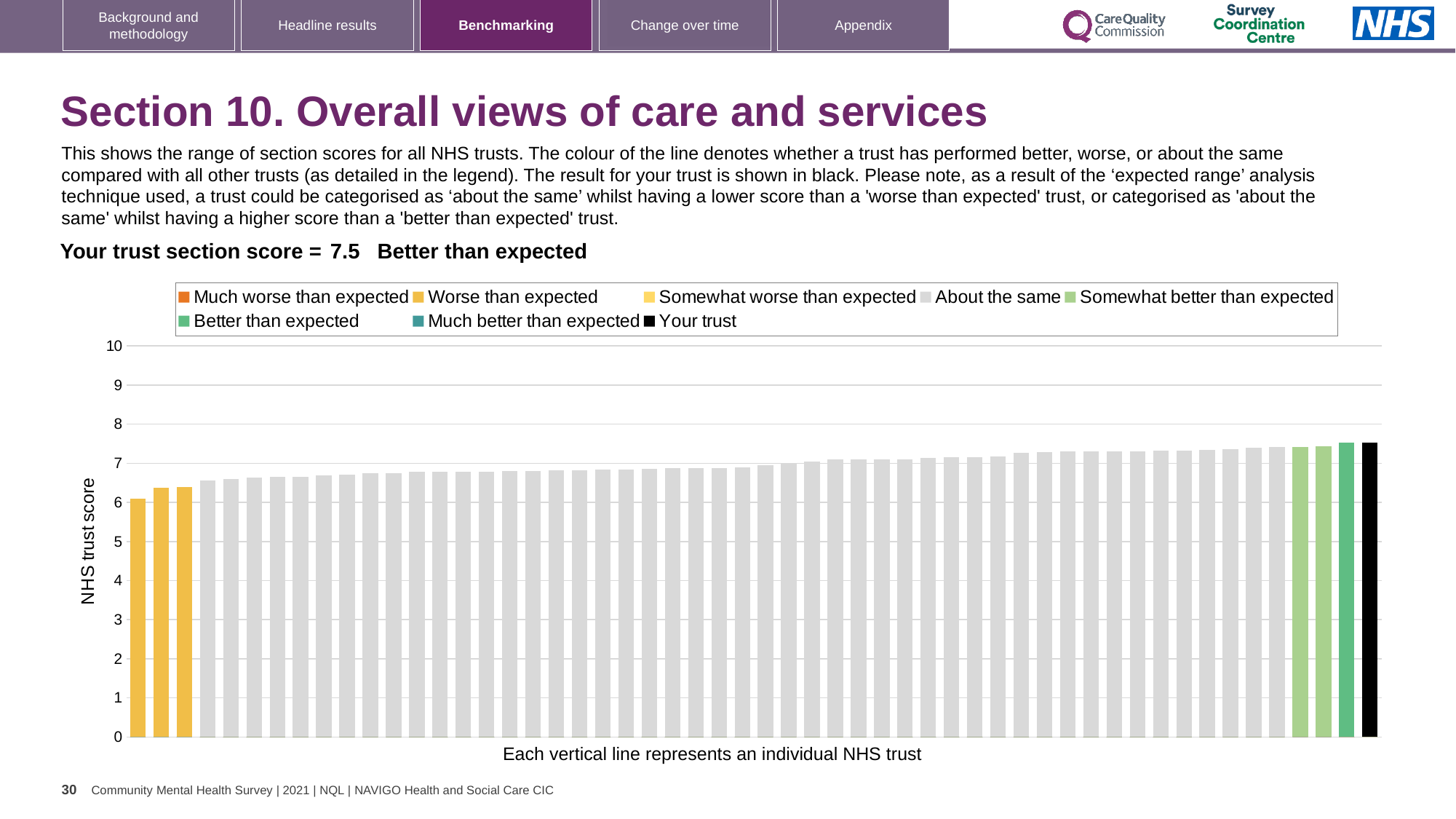
How many bars are coloured as 'Somewhat better than expected' (light green)? 2 Is the value of the bar for your trust greater or less than 8? less How many bars are coloured as 'Worse than expected' (dark yellow)? 3 What colour is the bar representing your trust? black Which performance category is your trust placed in for this section? Better than expected What is the section score for your trust? 7.5 Is the value of the leftmost (lowest) bar greater or less than 7? less What kind of chart is shown on the slide? bar chart How many entries does the chart legend list? 8 Do the bar values rise or fall from left to right along the x axis? rise Which is larger, the leftmost bar or the rightmost (black) bar? the rightmost (black) bar